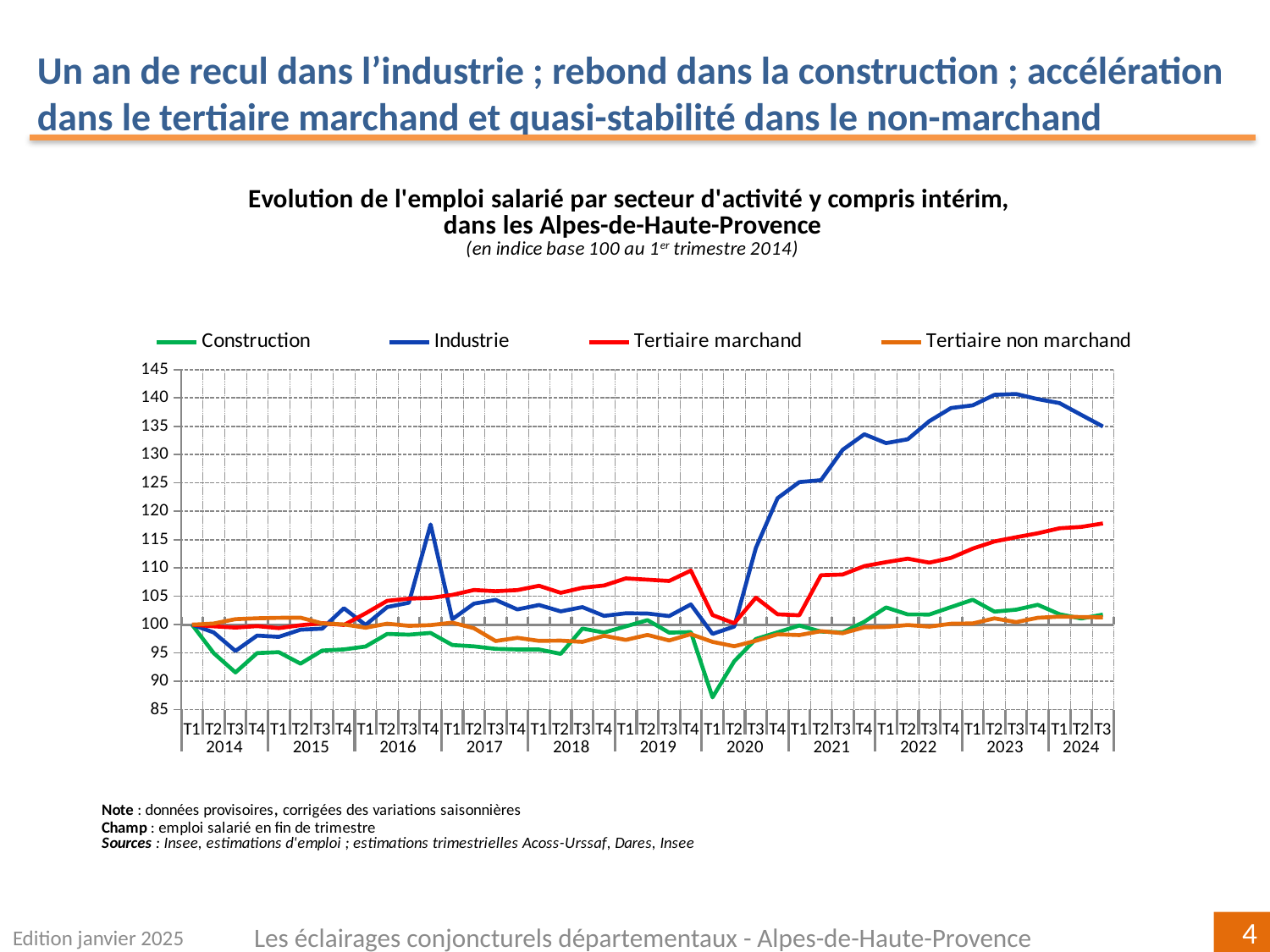
Which series has the highest value at T3 2024? Industrie Is the value for Construction at T1 2020 greater or less than 90? less Does the Industrie series rise or fall between T3 2023 and T3 2024? fall How many series does the legend list? 4 What is the index value of all series at T1 2014? 100 Which series has the lowest value at T1 2020? Construction Is the value for Industrie at T3 2024 greater or less than 130? greater Is the value for Tertiaire marchand at T3 2024 greater or less than 115? greater Which series are listed in the legend? Construction, Industrie, Tertiaire marchand, Tertiaire non marchand What kind of chart is shown on the slide? line chart At T3 2024, which is larger: Industrie or Tertiaire marchand? Industrie